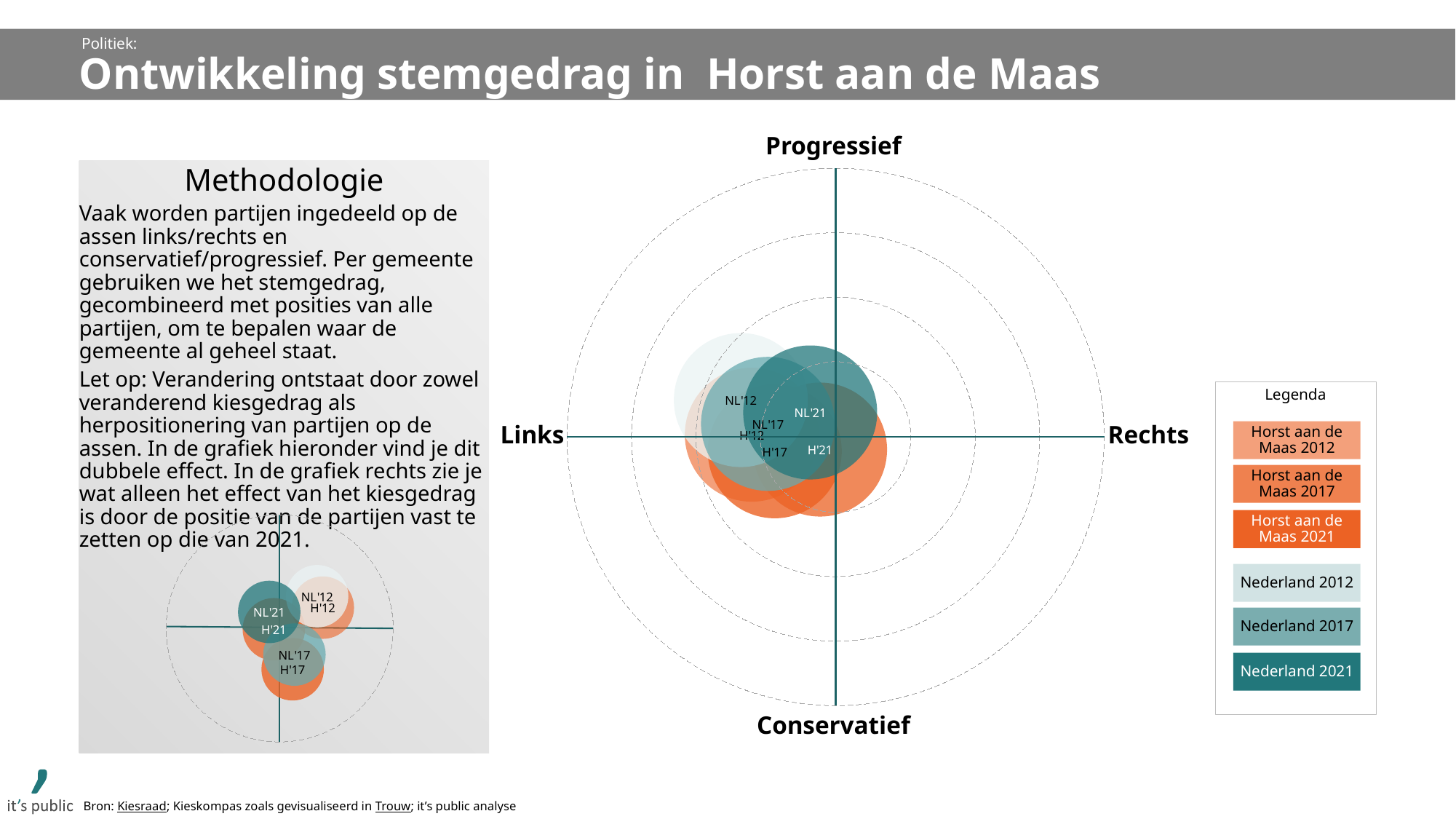
In the large central chart, which label is at the top end of the vertical axis? Progressief In the large central chart, is the NL'12 bubble on the Links side or the Rechts side of the vertical axis? Links How many labelled bubbles are plotted in the large central chart? 6 What kind of chart is the large chart in the centre of the slide? Bubble chart In the small chart in the Methodologie panel, is the H'17 bubble above or below the horizontal axis? Below How many entries does the legend (Legenda) list? 6 In the legend, what colour family is used for the Nederland entries? Teal/green How many labelled bubbles are plotted in the small chart inside the Methodologie panel on the left? 6 In the large central chart, is the NL'21 bubble above or below the horizontal Links–Rechts axis? Above